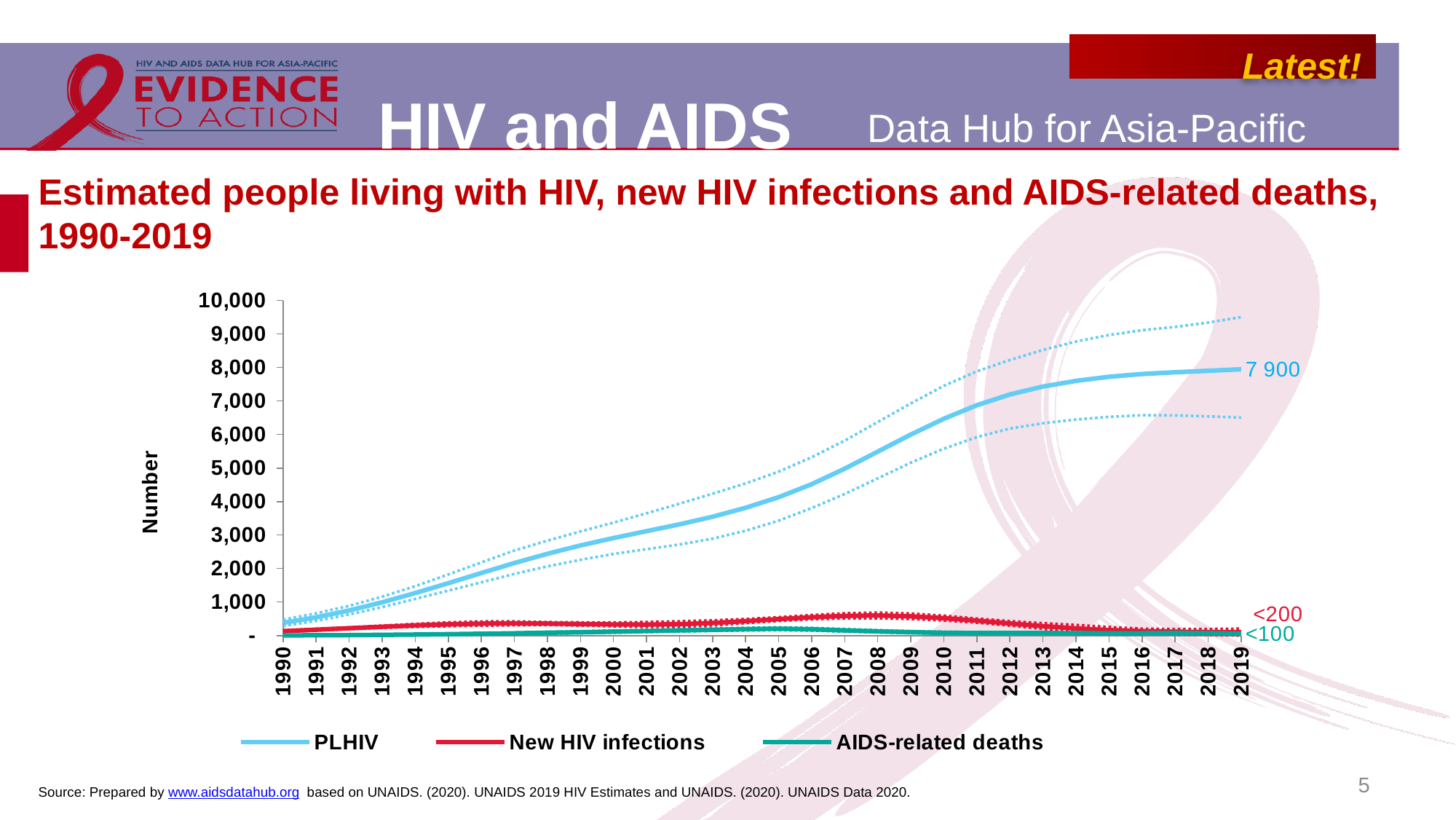
What is the value for PLHIV in 2019? 7 900 How many years are plotted along the x axis? 30 Is the value for PLHIV in 2010 greater or less than 5,000? greater In 2019, which is larger: PLHIV or New HIV infections? PLHIV What is the label on the y axis? Number Does the PLHIV line rise or fall from 1990 to 2019? Rise What kind of chart is shown on the slide? Line chart What is the value shown for New HIV infections in 2019? <200 Is the value for PLHIV in 1995 greater or less than 2,000? less How many series does the legend list? 3 What is the value shown for AIDS-related deaths in 2019? <100 Which series has the highest value in 2019? PLHIV